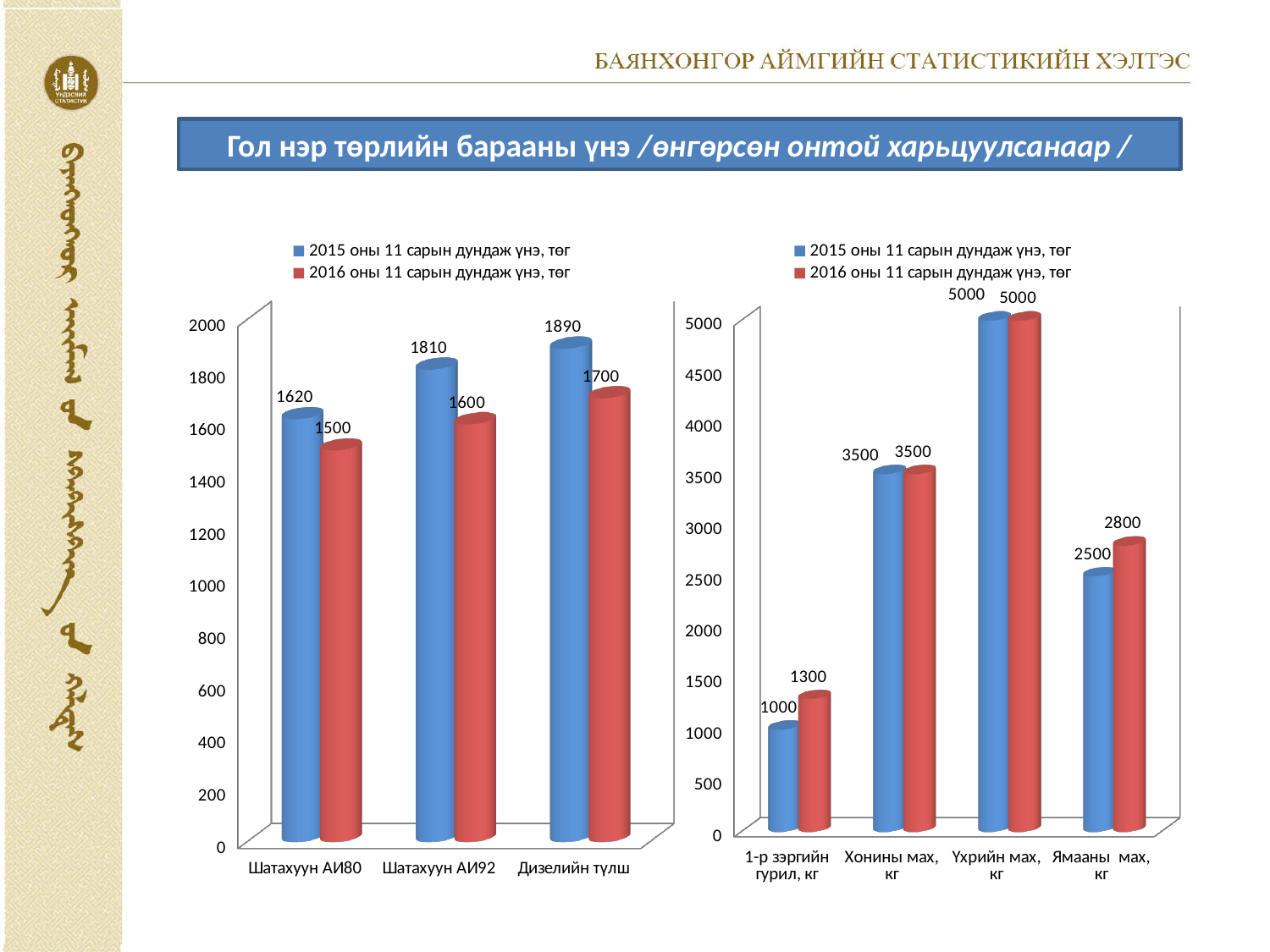
What type of chart is the right chart? Bar chart In the left chart, what is the difference between the 2015 and 2016 values for Шатахуун АИ92? 210 In the left chart, which category has the highest 2015 оны 11 сарын дундаж үнэ? Дизелийн түлш How many series does the legend of the right chart list? 2 In the left chart, do the 2016 values rise or fall from Шатахуун АИ80 to Дизелийн түлш? rise In the right chart, what is the 2016 оны 11 сарын дундаж үнэ for 1-р зэргийн гурил, кг? 1300 In the right chart, which is larger for Хонины мах, кг: the 2015 value or the 2016 value? They are equal (3500) In the left chart, what is the 2015 оны 11 сарын дундаж үнэ for Шатахуун АИ92? 1810 In the right chart, which category has the lowest 2015 оны 11 сарын дундаж үнэ? 1-р зэргийн гурил, кг In the left chart, what is the 2016 оны 11 сарын дундаж үнэ for Дизелийн түлш? 1700 In the left chart, how many categories are shown on the x axis? 3 In the right chart, what is the difference between the 2016 and 2015 values for Ямааны мах, кг? 300